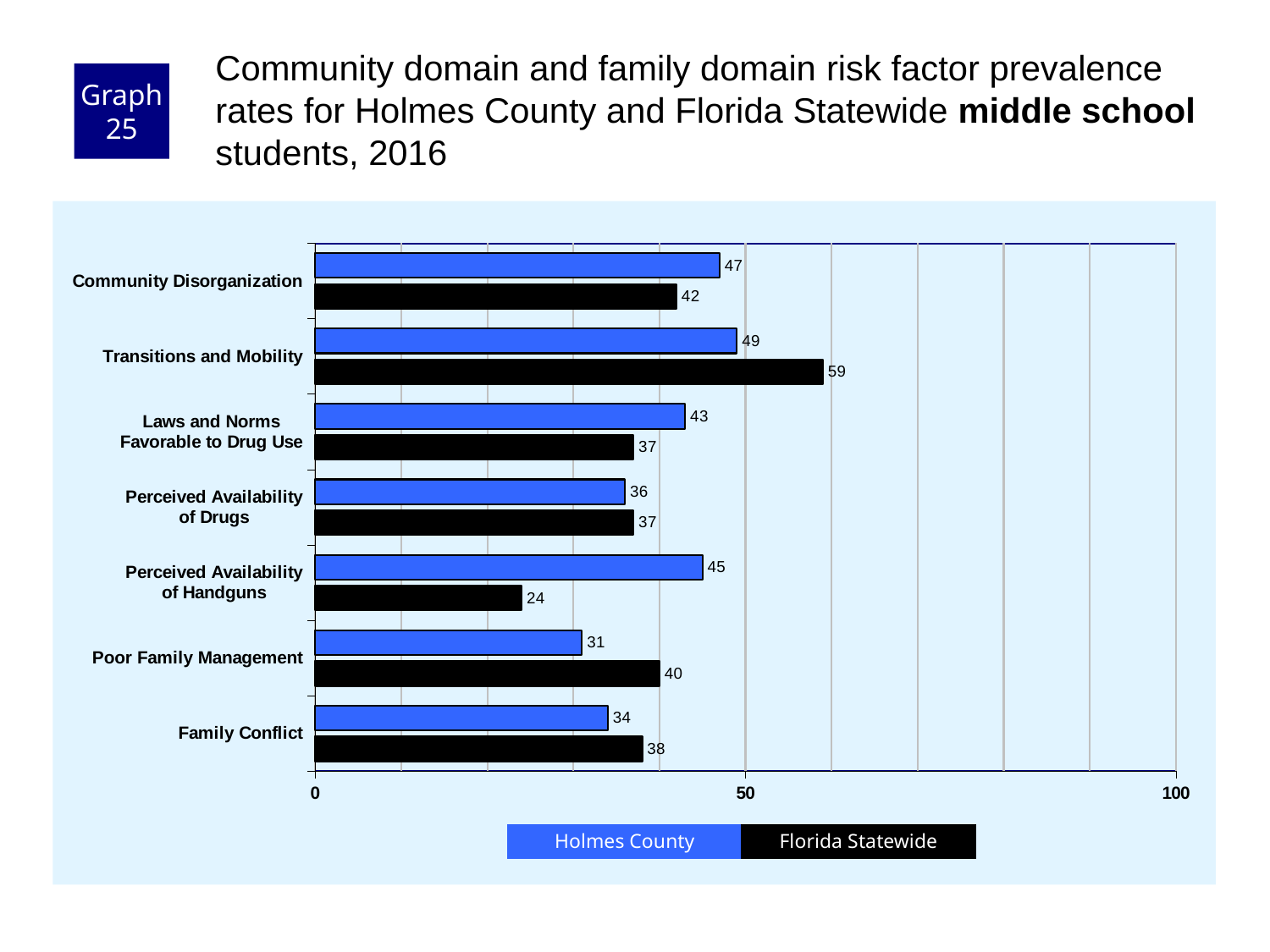
How many risk factors are shown on the chart? 7 What is the Holmes County value for Community Disorganization? 47 Which risk factor has the lowest Florida Statewide value? Perceived Availability of Handguns What is the Florida Statewide value for Transitions and Mobility? 59 For Poor Family Management, which is larger: the Holmes County value or the Florida Statewide value? Florida Statewide What kind of chart is shown on the slide? bar chart What is the difference between the Holmes County and Florida Statewide values for Perceived Availability of Handguns? 21 Which risk factor has the highest Holmes County value? Transitions and Mobility How many series does the legend list? 2 Is the Florida Statewide value for Transitions and Mobility greater or less than 50? greater Which colour represents Florida Statewide in the chart? black What is the Florida Statewide value for Perceived Availability of Handguns? 24